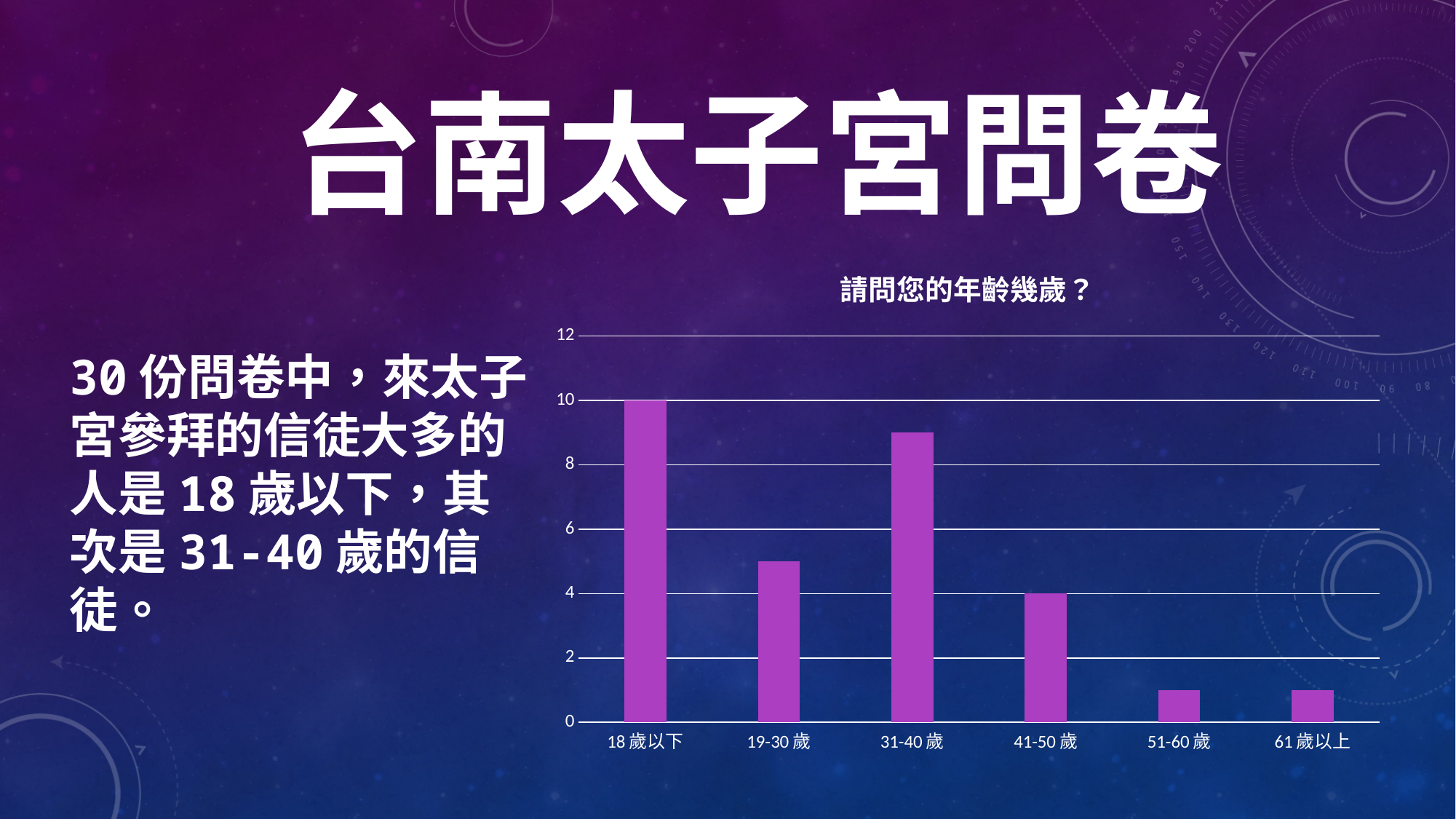
Is the value for 51-60 歲 greater or less than 2? less What is the difference between the values for 18 歲以下 and 41-50 歲? 6 Which is larger, the value for 18 歲以下 or the value for 31-40 歲? 18 歲以下 What is the title of the chart? 請問您的年齡幾歲？ Is the value for 31-40 歲 greater or less than 8? greater What kind of chart is shown on the slide? bar chart What is the value for 41-50 歲? 4 Which age group has the highest value? 18 歲以下 Is the value for 19-30 歲 greater or less than 6? less How many age categories are shown on the x axis? 6 Which is larger, the value for 31-40 歲 or the value for 19-30 歲? 31-40 歲 What is the value for 18 歲以下? 10